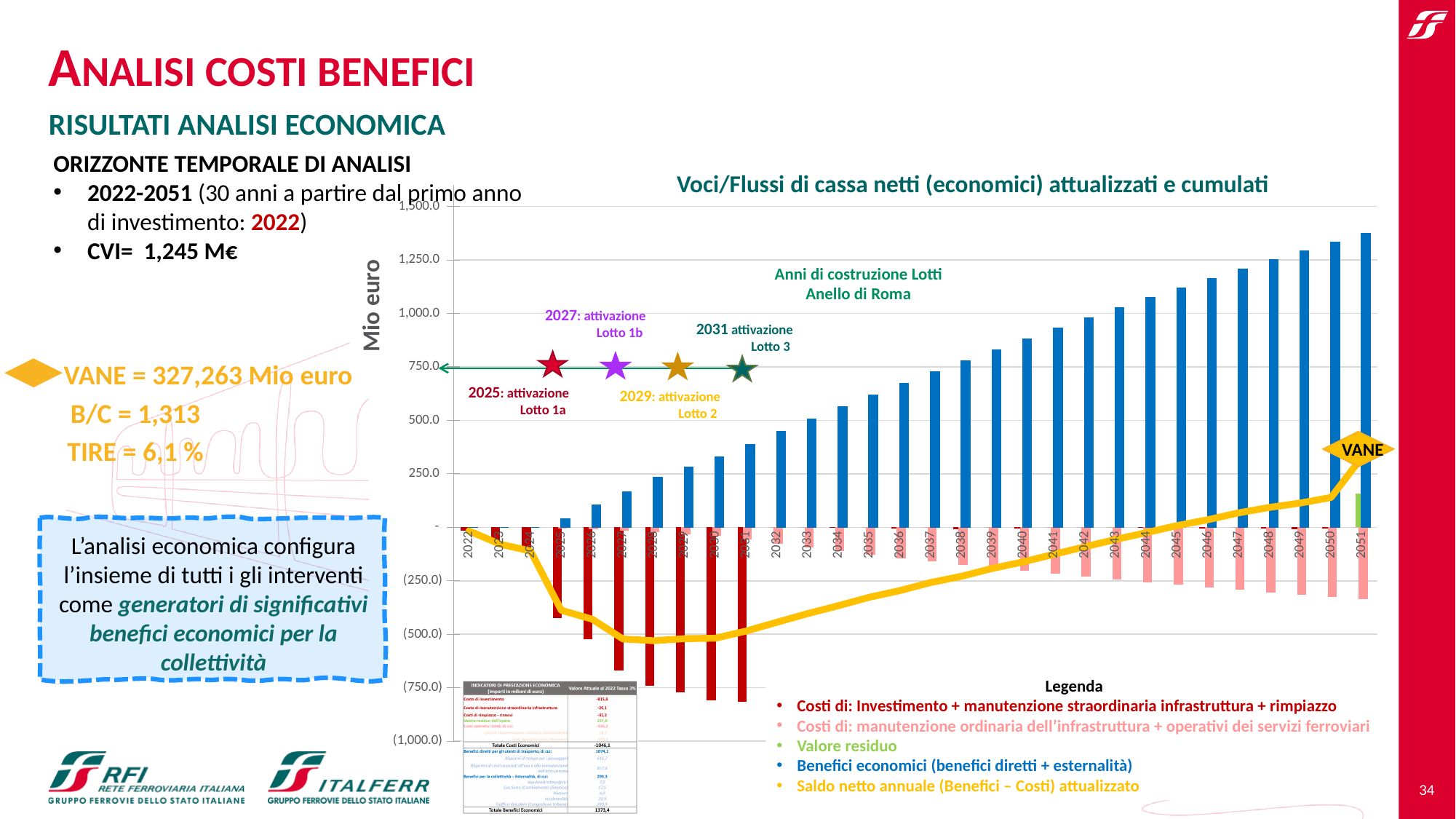
What is the label on the vertical axis of the chart? Mio euro How many years are shown along the x axis of the chart? 30 Do the blue bars (Benefici economici) rise or fall from 2025 to 2051? rise Is the blue bar (Benefici economici) for 2032 greater or less than 500.0? less How many entries does the chart's legend list? 5 What is the first year shown on the x axis of the chart? 2022 Is the blue bar (Benefici economici) for 2051 greater or less than 1,250.0? greater In which year is the blue bar (Benefici economici) the highest? 2051 What is the last year shown on the x axis of the chart? 2051 Which year has the larger blue bar (Benefici economici), 2040 or 2045? 2045 What is the title of the chart? Voci/Flussi di cassa netti (economici) attualizzati e cumulati Is the blue bar (Benefici economici) for 2041 greater or less than 750.0? greater